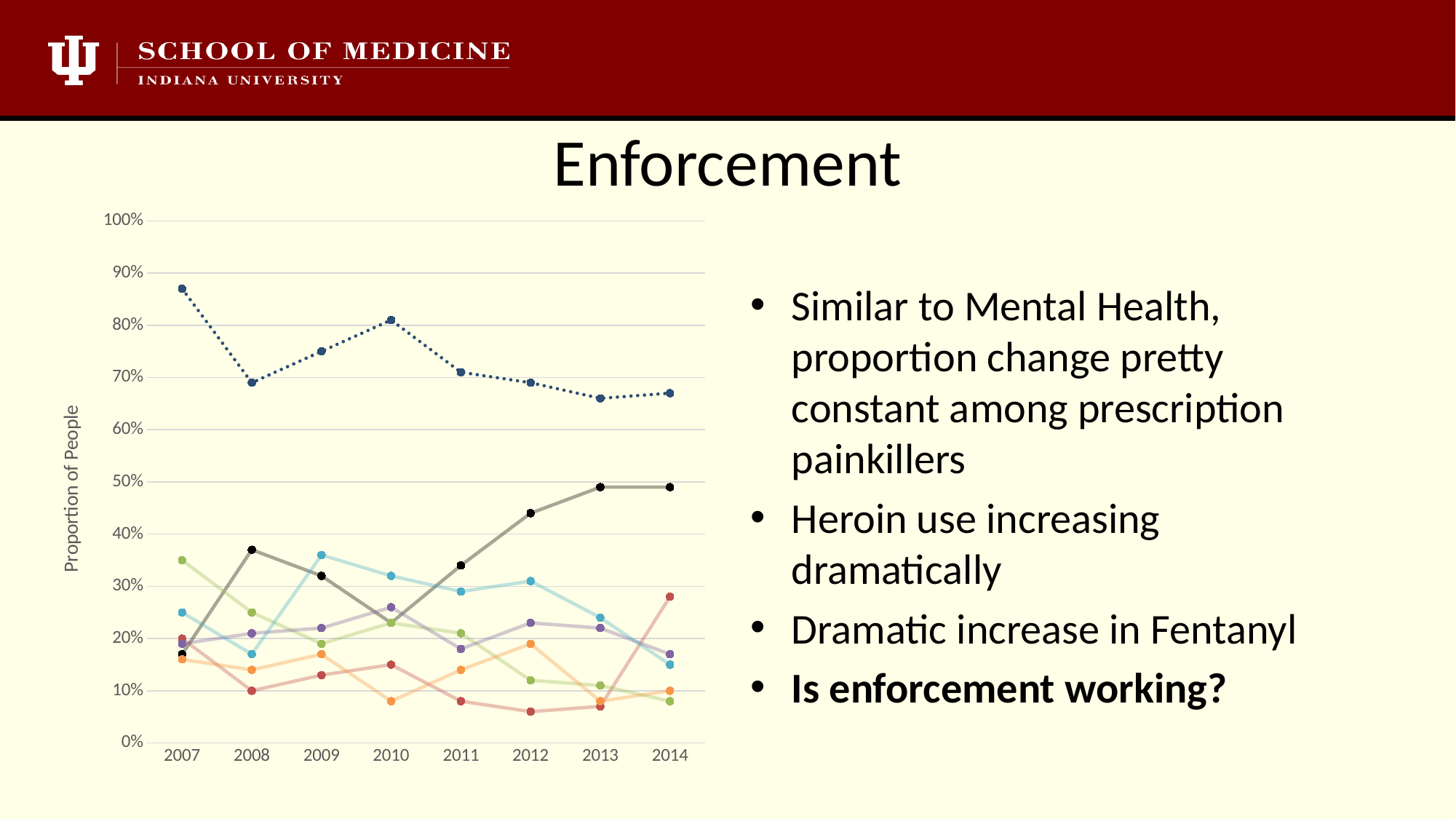
Is the value of the solid black line in 2007 greater or less than 20%? less Is the value of the dotted dark blue line in 2014 greater or less than 70%? less How many years are shown along the x axis of the chart? 8 For the dotted dark blue line, is the value in 2007 or in 2008 larger? 2007 Is the value of the solid black line in 2012 greater or less than 40%? greater What kind of chart is shown on the slide? line chart In which year does the solid black line have its lowest value? 2007 In which year does the dotted dark blue line reach its highest value? 2007 Does the solid black line rise or fall from 2010 to 2014? rise What is the first year shown on the x axis of the chart? 2007 What is the title of the y axis of the chart? Proportion of People